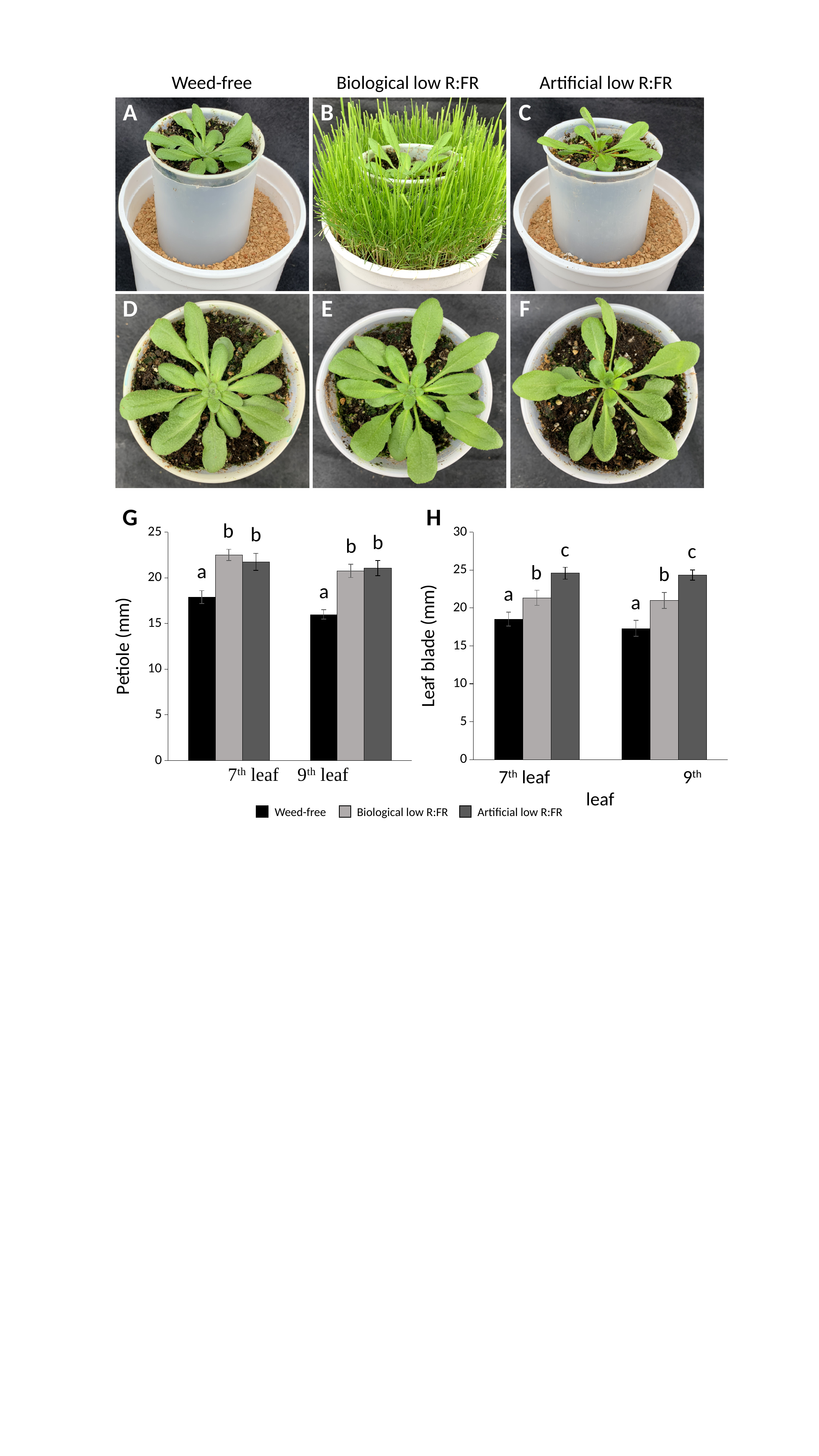
In chart H (Leaf blade), which treatment has the highest value for the 7th leaf? Artificial low R:FR In chart G (Petiole), for the 9th leaf, which is larger: Weed-free or Artificial low R:FR? Artificial low R:FR In chart G (Petiole), is the Biological low R:FR value for the 7th leaf greater or less than 20? greater In chart G (Petiole), which treatment has the lowest value for the 7th leaf? Weed-free In chart H, what is the label on the y axis? Leaf blade (mm) In chart H (Leaf blade), is the Weed-free value for the 9th leaf greater or less than 20? less In chart H (Leaf blade), is the Artificial low R:FR value for the 9th leaf greater or less than 20? greater What kind of chart is chart G (Petiole)? bar chart In chart G (Petiole), is the Weed-free value larger for the 7th leaf or the 9th leaf? 7th leaf In chart G (Petiole), how many series does the legend list? 3 In chart H (Leaf blade), how many leaf categories are shown on the x axis? 2